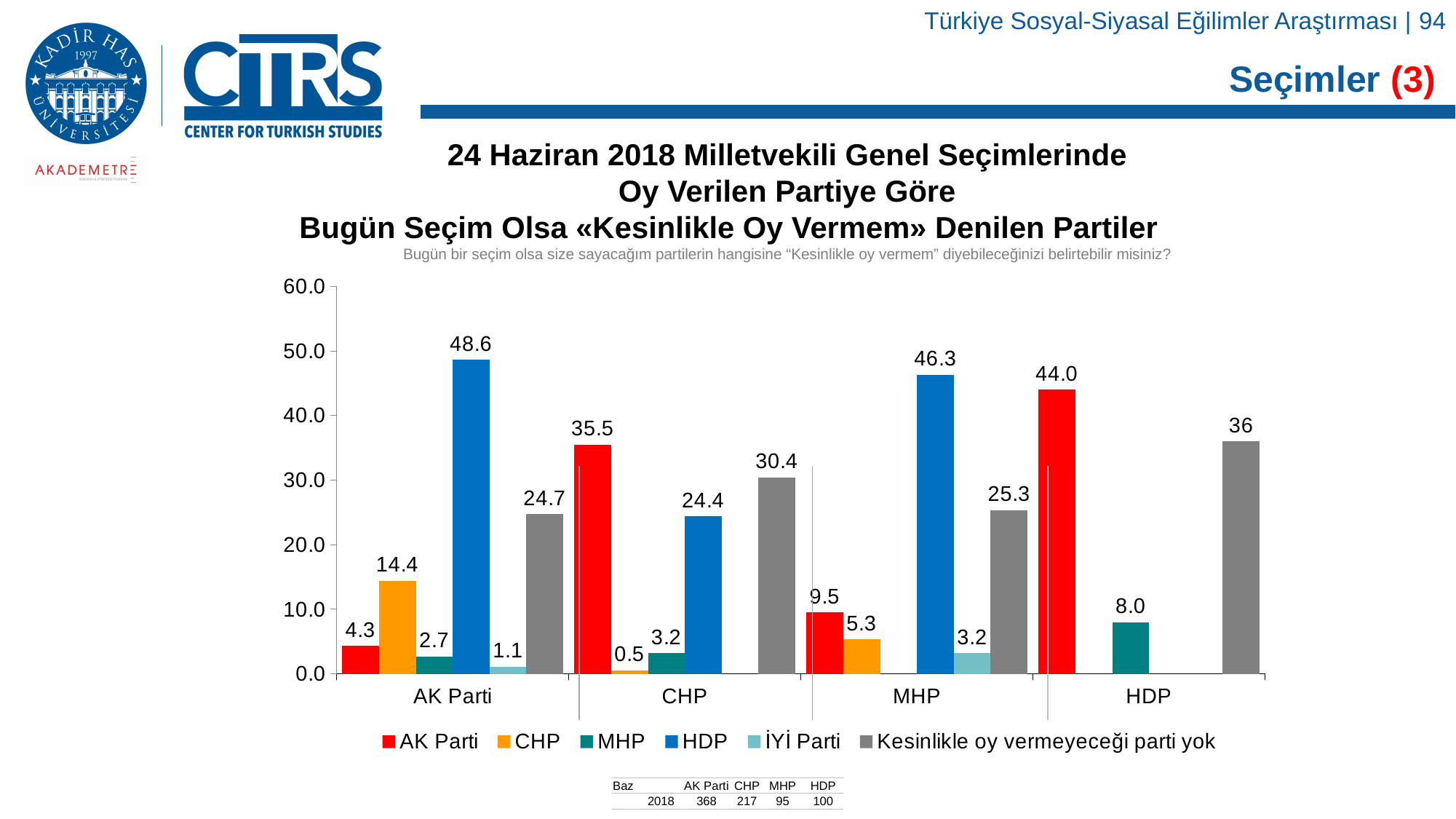
What is the 'Kesinlikle oy vermeyeceği parti yok' value for the HDP category? 36 What is the HDP value for the AK Parti category? 48.6 What is the İYİ Parti value for the MHP category? 3.2 Which series has the highest value in the MHP category? HDP Which colour represents the HDP series in the legend? blue How many series does the legend list? 6 What is the AK Parti value for the CHP category? 35.5 What is the difference between the HDP value and the 'Kesinlikle oy vermeyeceği parti yok' value in the AK Parti category? 23.9 How many voter-party categories are shown on the x axis? 4 Which is larger in the HDP category: the AK Parti value or the 'Kesinlikle oy vermeyeceği parti yok' value? AK Parti Which series has the lowest value in the CHP category? CHP What kind of chart is shown on the slide? bar chart